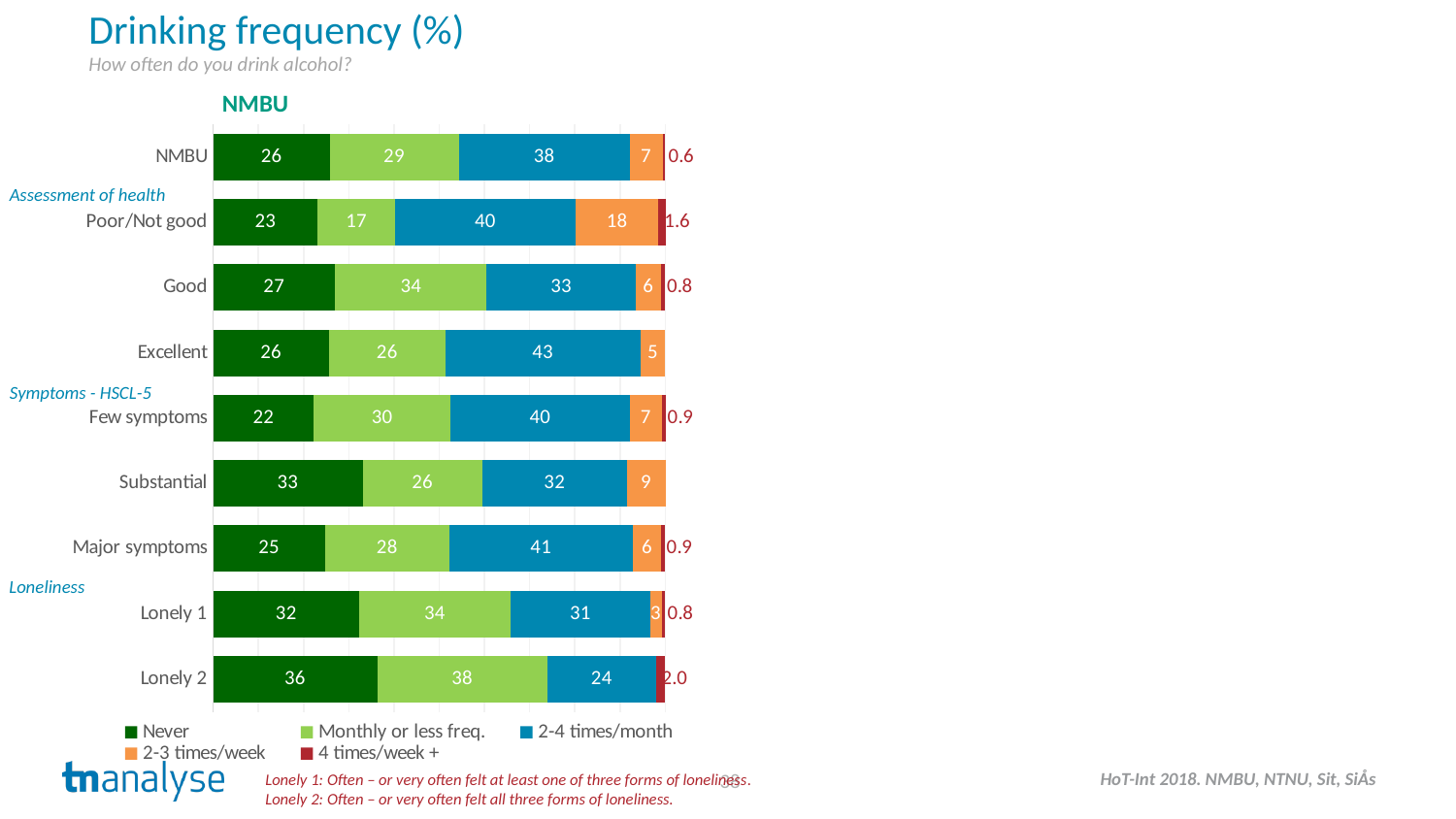
How many series does the legend list? 5 What is the value for "2-3 times/week" in the Poor/Not good category? 18 What is the difference between the "Monthly or less freq." values for Good and Poor/Not good? 17 Which category has the lowest value for "Never"? Few symptoms How many categories (bars) are shown in the chart? 9 Which has a larger "Never" value, Lonely 2 or NMBU? Lonely 2 What kind of chart is shown on the slide? Stacked bar chart What percentage of Lonely 2 respondents answered "Never"? 36 What is the value for "4 times/week +" in the Lonely 2 category? 2.0 What is the title of the chart? Drinking frequency (%) Which category has the highest value for "2-3 times/week"? Poor/Not good Which category has the highest value for "2-4 times/month"? Excellent